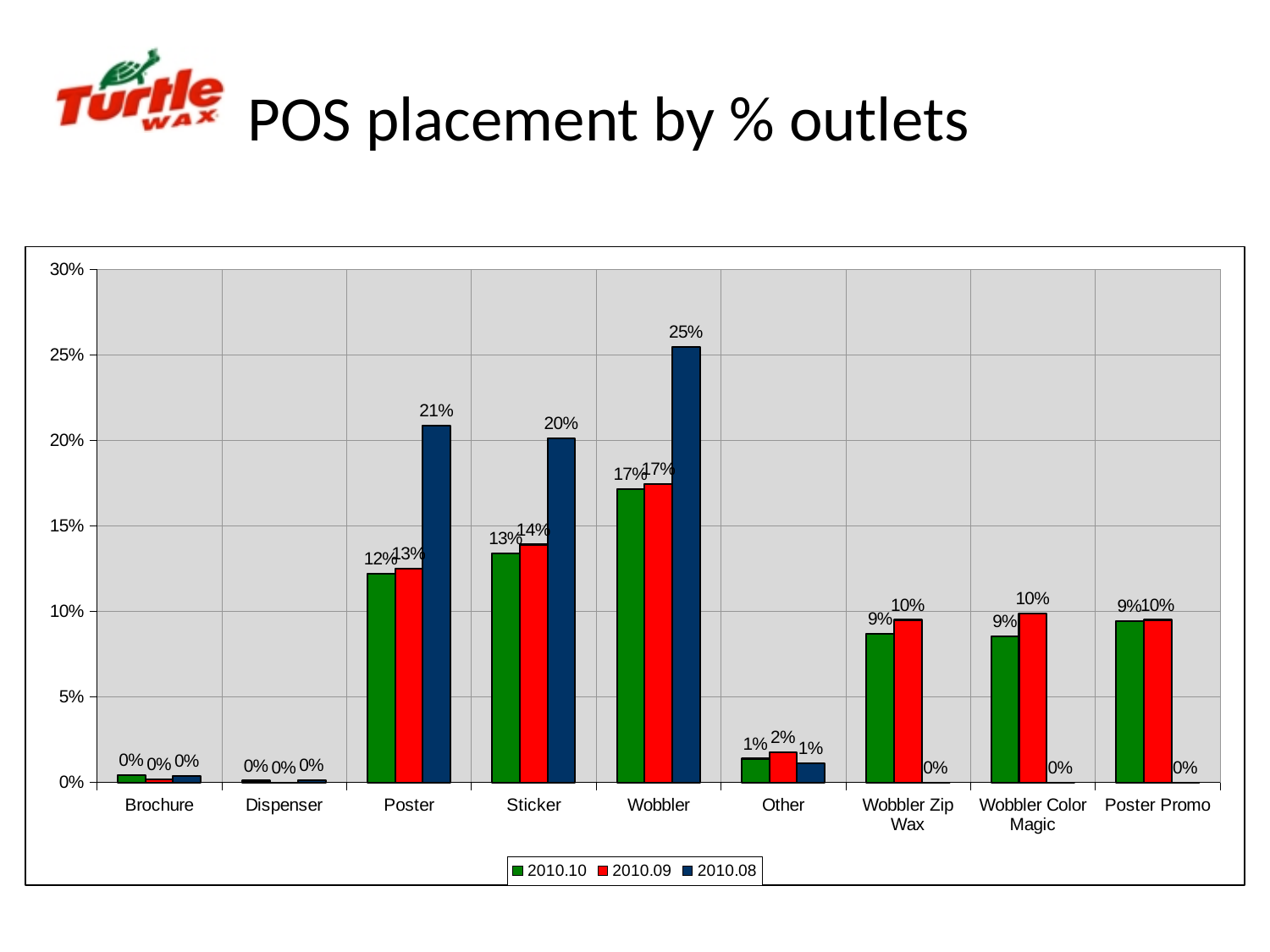
What is the difference between the 2010.08 values for Wobbler and Poster? 4% How many categories are shown on the x axis? 9 Is the 2010.10 value for Wobbler greater or less than 15%? greater What kind of chart is shown on the slide? bar chart What is the value for Wobbler in the 2010.08 series? 25% What is the value for Sticker in the 2010.09 series? 14% What is the title of the chart? POS placement by % outlets How many series does the legend list? 3 What is the value for Poster in the 2010.08 series? 21% What is the value for Wobbler Zip Wax in the 2010.08 series? 0% Which is larger in the 2010.08 series: Poster or Sticker? Poster Which category has the highest value in the 2010.08 series? Wobbler